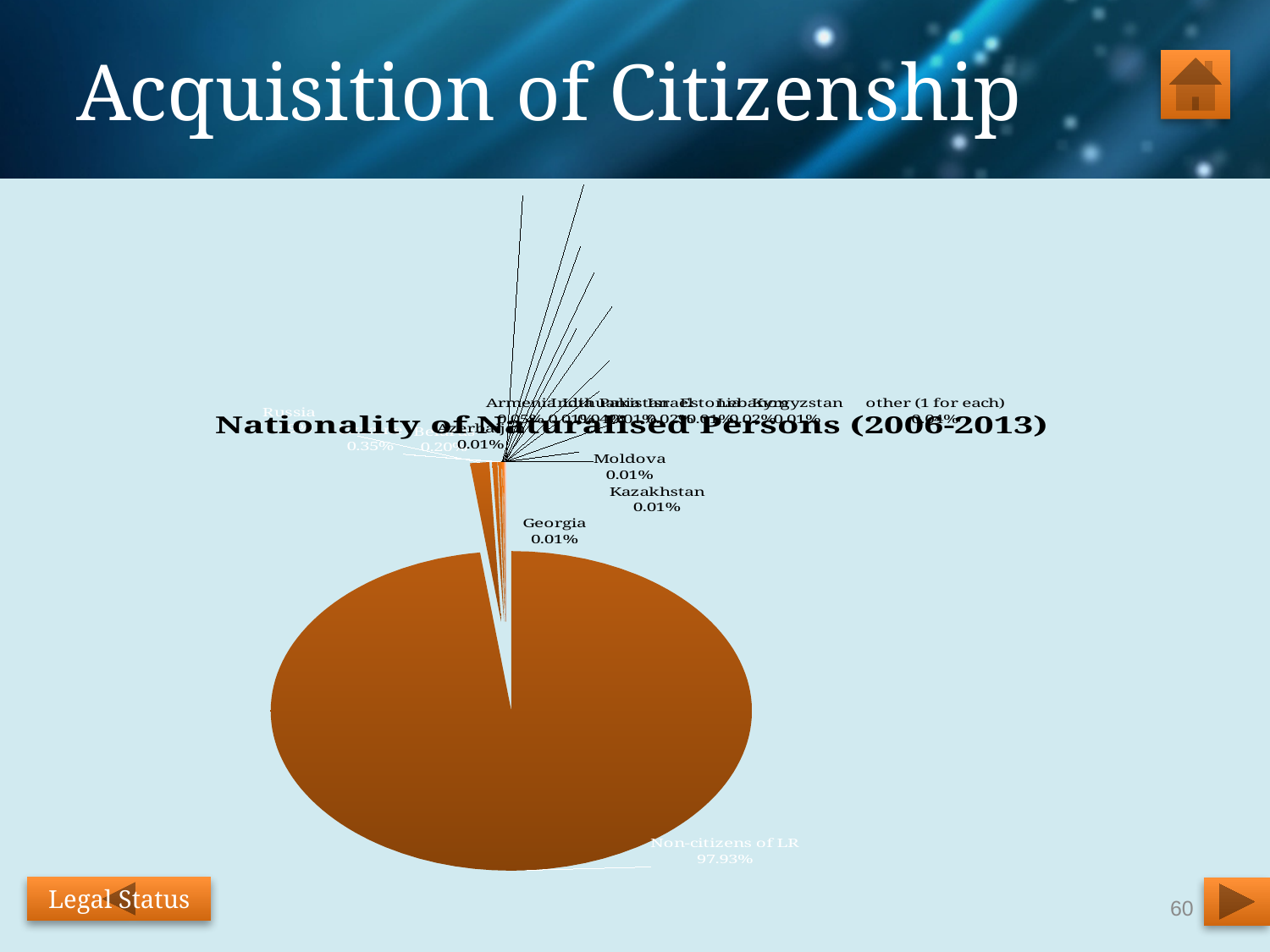
What is the value shown for Georgia? 0.01% What is the title of the chart? Nationality of Naturalised Persons (2006-2013) What kind of chart is shown on the slide? pie chart What is the value shown for Kazakhstan? 0.01% What is the value shown for Moldova? 0.01% Which category has the largest slice of the pie? Non-citizens of LR Which is larger, the value for Russia or the value for Georgia? Russia What share of the pie is labelled for Non-citizens of LR? 97.93%